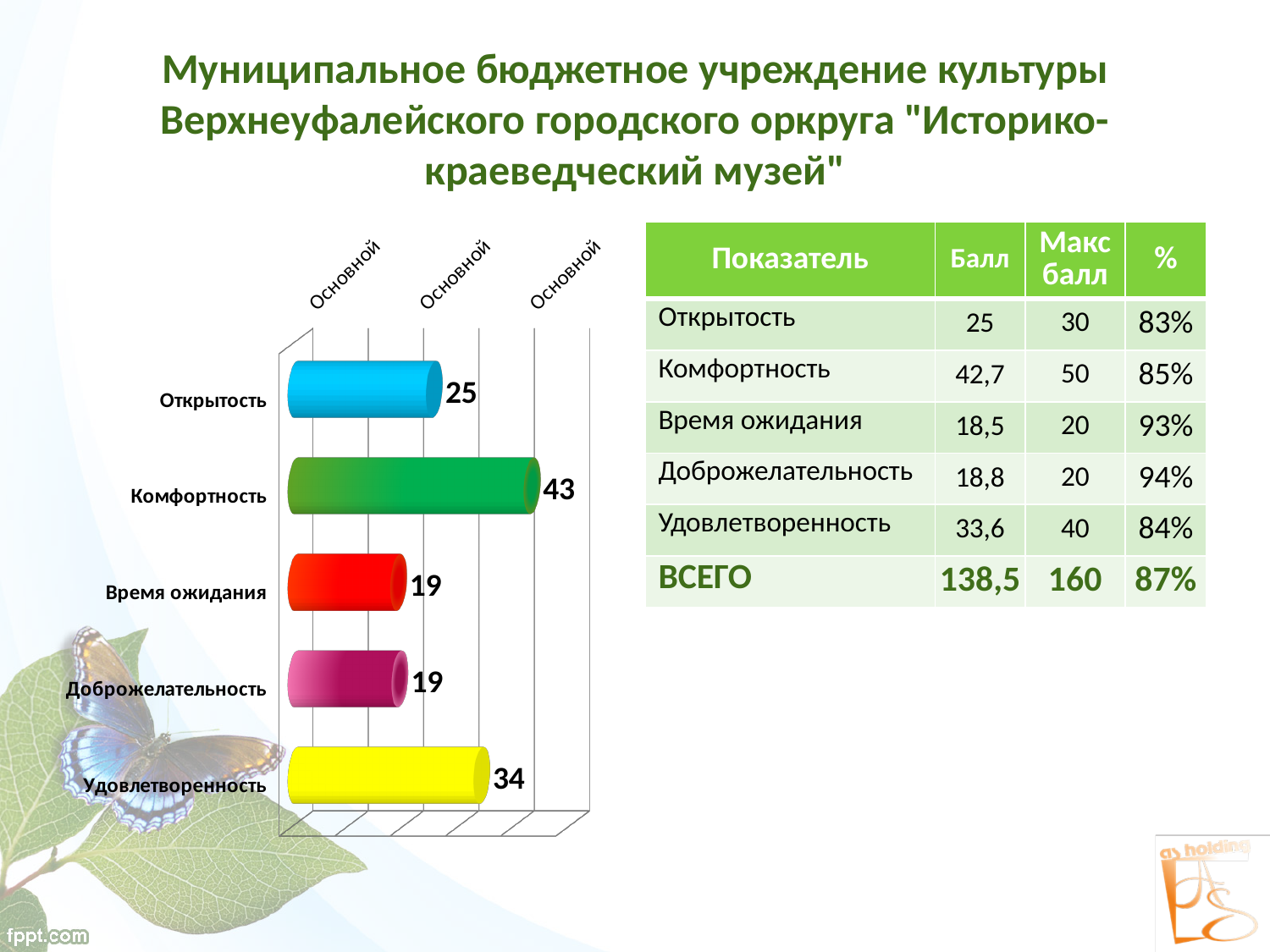
What is the value shown for Комфортность in the chart? 43 Which is larger in the chart, the value for Удовлетворенность or the value for Открытость? Удовлетворенность Which category has the highest value in the chart? Комфортность What colour is the bar for Удовлетворенность in the chart? Yellow What is the value shown for Время ожидания in the chart? 19 Which two categories share the lowest value in the chart? Время ожидания and Доброжелательность How many categories are plotted in the chart? 5 What is the difference between the values for Комфортность and Открытость in the chart? 18 What kind of chart is shown on the slide? Bar chart What is the difference between the values for Удовлетворенность and Доброжелательность in the chart? 15 What is the value shown for Удовлетворенность in the chart? 34 What is the value shown for Открытость in the chart? 25